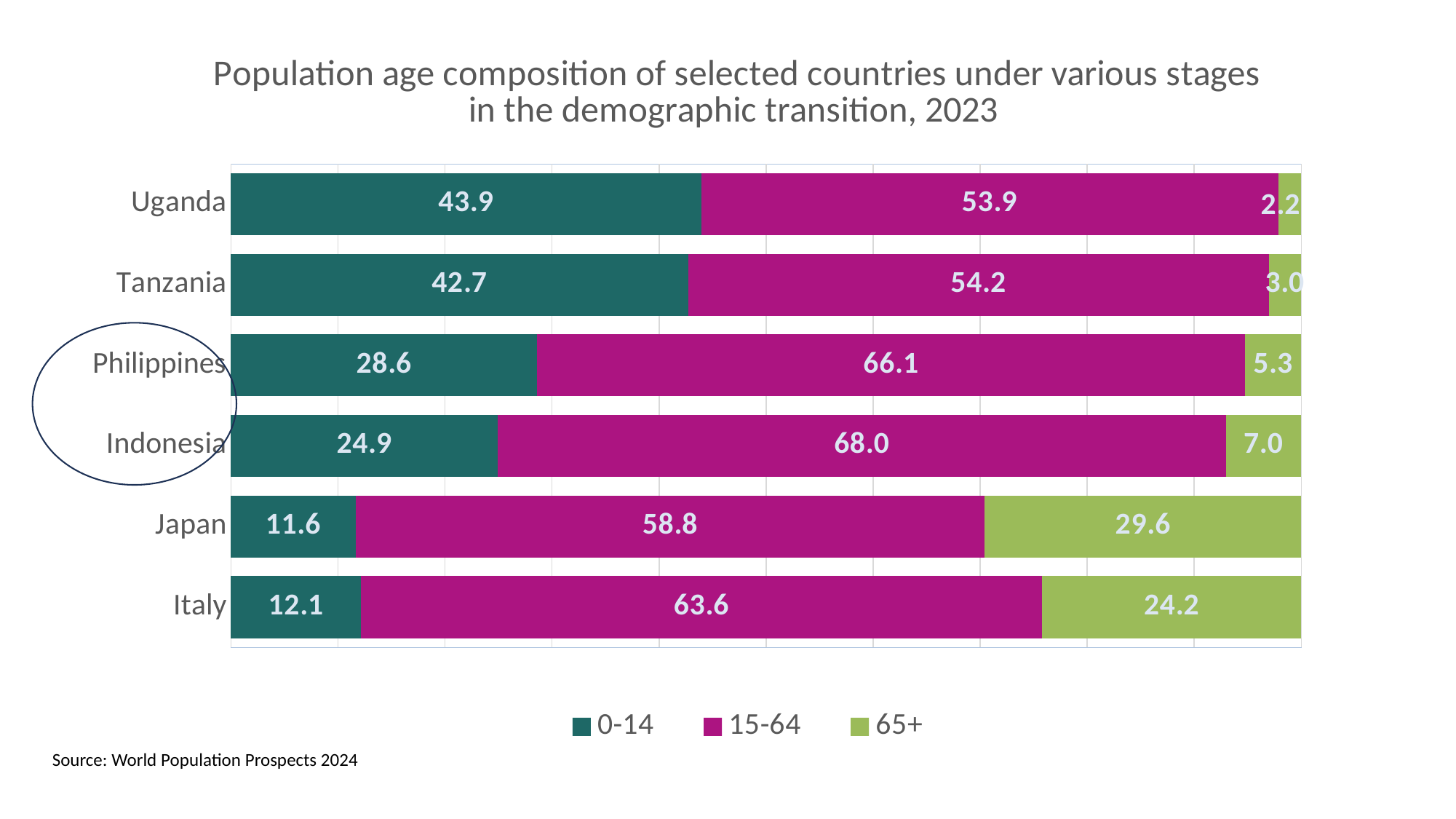
What is the value for the 65+ age group in Japan? 29.6 What is the total of the stacked bar for Uganda? 100.0 What is the difference between the 65+ values for Japan and Italy? 5.4 Which is larger, the 15-64 value for Indonesia or for Tanzania? Indonesia How many series does the legend list? 3 What is the value for the 0-14 age group in Uganda? 43.9 What kind of chart is shown on the slide? Stacked bar chart Which country has the highest value for the 65+ age group? Japan What is the value for the 15-64 age group in the Philippines? 66.1 Which country has the lowest value for the 65+ age group? Uganda Which country has the highest value for the 0-14 age group? Uganda How many countries are shown in the chart? 6